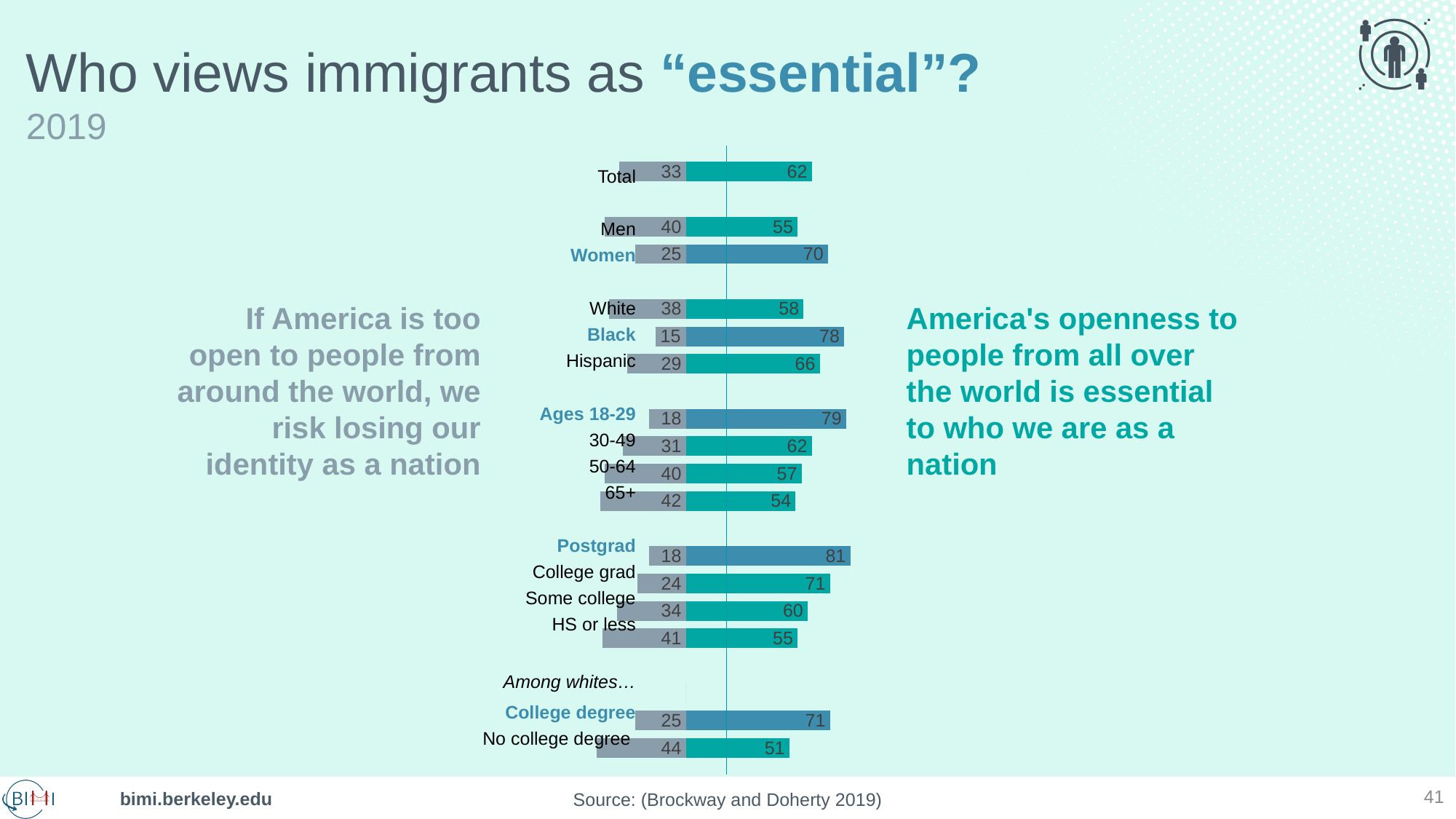
Which category has the highest value for 'America's openness to people from all over the world is essential'? Postgrad What value is shown for Postgrad respondents on the 'America's openness... is essential' side of the chart? 81 What is the value for 65+ on the 'If America is too open... we risk losing our identity' side? 42 Moving from Postgrad down to HS or less, do the values for 'America's openness... is essential' rise or fall? Fall What value is shown for Black respondents on the 'If America is too open... we risk losing our identity' side of the chart? 15 What is the difference between Women (70) and Men (55) on the 'openness is essential' side? 15 Among whites, which group has the larger value for 'If America is too open... we risk losing our identity': College degree or No college degree? No college degree What type of chart is shown on the slide? Bar chart Which age group has the highest value for 'America's openness... is essential'? Ages 18-29 Which category has the lowest value for 'If America is too open to people from around the world, we risk losing our identity as a nation'? Black What percentage of the Total group says America's openness to people from all over the world is essential to who we are as a nation? 62 How many categories (rows) are plotted in the chart? 16